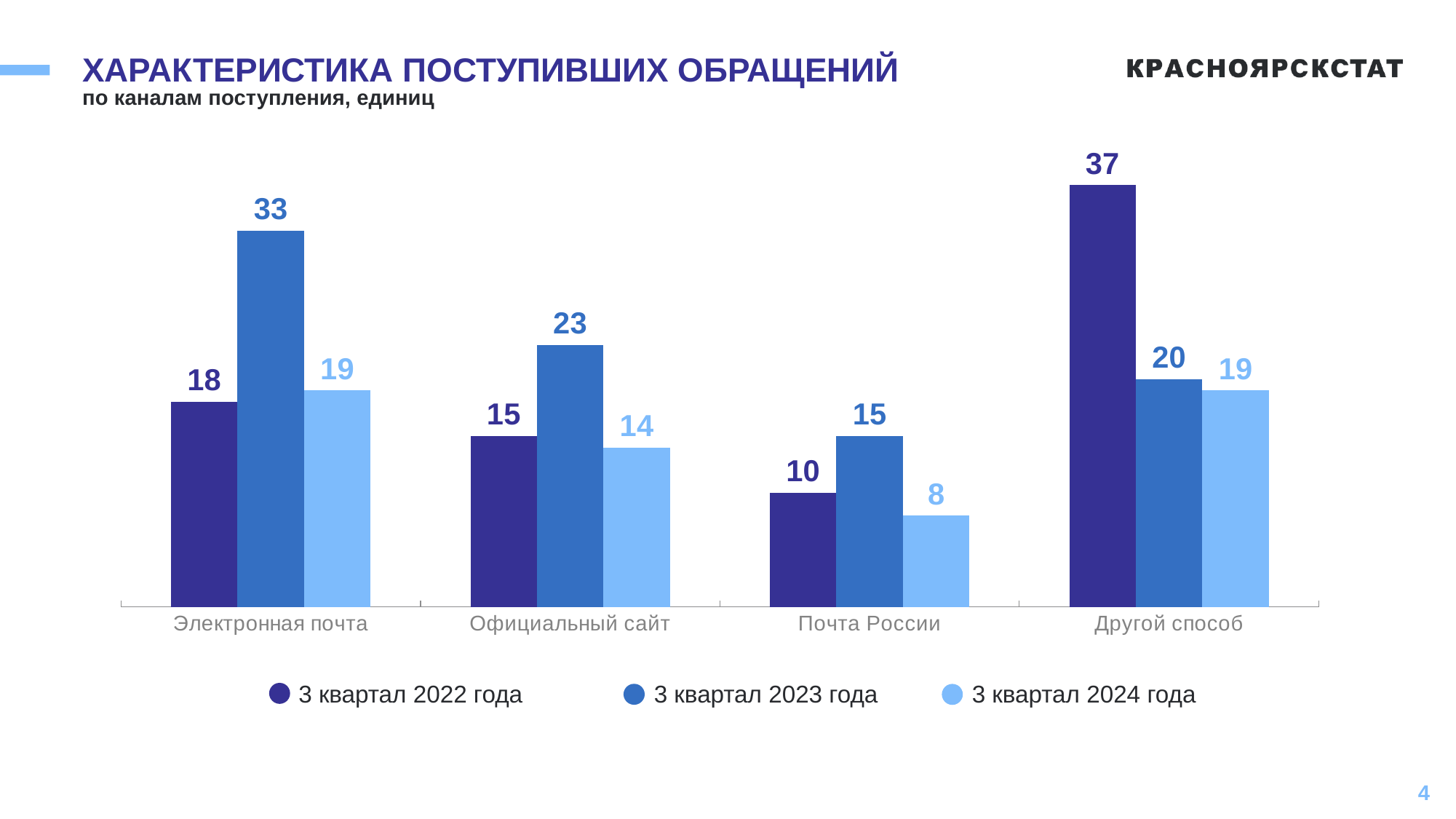
Which is larger for Другой способ: the value for 3 квартал 2023 года or 3 квартал 2024 года? 3 квартал 2023 года What is the value for Другой способ in 3 квартал 2022 года? 37 What is the difference between the 3 квартал 2023 года and 3 квартал 2024 года values for Официальный сайт? 9 How many categories are shown on the x axis? 4 What is the value for Почта России in 3 квартал 2024 года? 8 Which category has the lowest value in 3 квартал 2024 года? Почта России What kind of chart is shown on the slide? Bar chart How many series does the legend list? 3 What is the value for Электронная почта in 3 квартал 2023 года? 33 Which category has the highest value in 3 квартал 2022 года? Другой способ Do the values for Почта России rise or fall from 3 квартал 2023 года to 3 квартал 2024 года? Fall What is the subtitle under the chart title? по каналам поступления, единиц